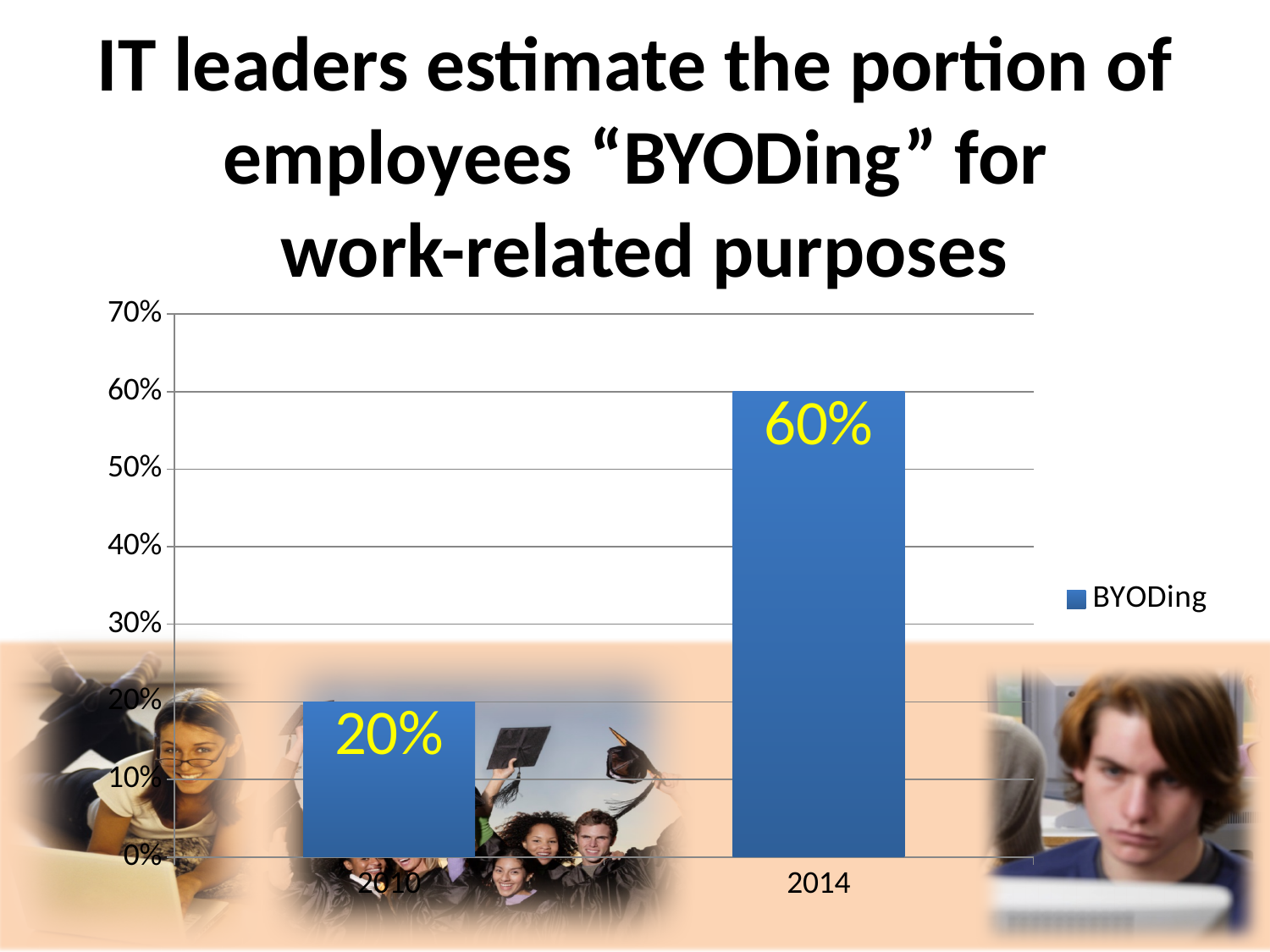
What is the difference between the values for 2014 and 2010? 40% What is the name of the series shown in the legend? BYODing Which year has the highest value? 2014 How many series does the legend list? 1 Is the value for 2014 greater or less than 50%? greater How many categories are shown on the x axis? 2 What is the value for 2010? 20% What is the value for 2014? 60% Which is larger, the value for 2010 or the value for 2014? 2014 Is the value for 2010 greater or less than 30%? less What kind of chart is shown on the slide? bar chart Which year has the lowest value? 2010